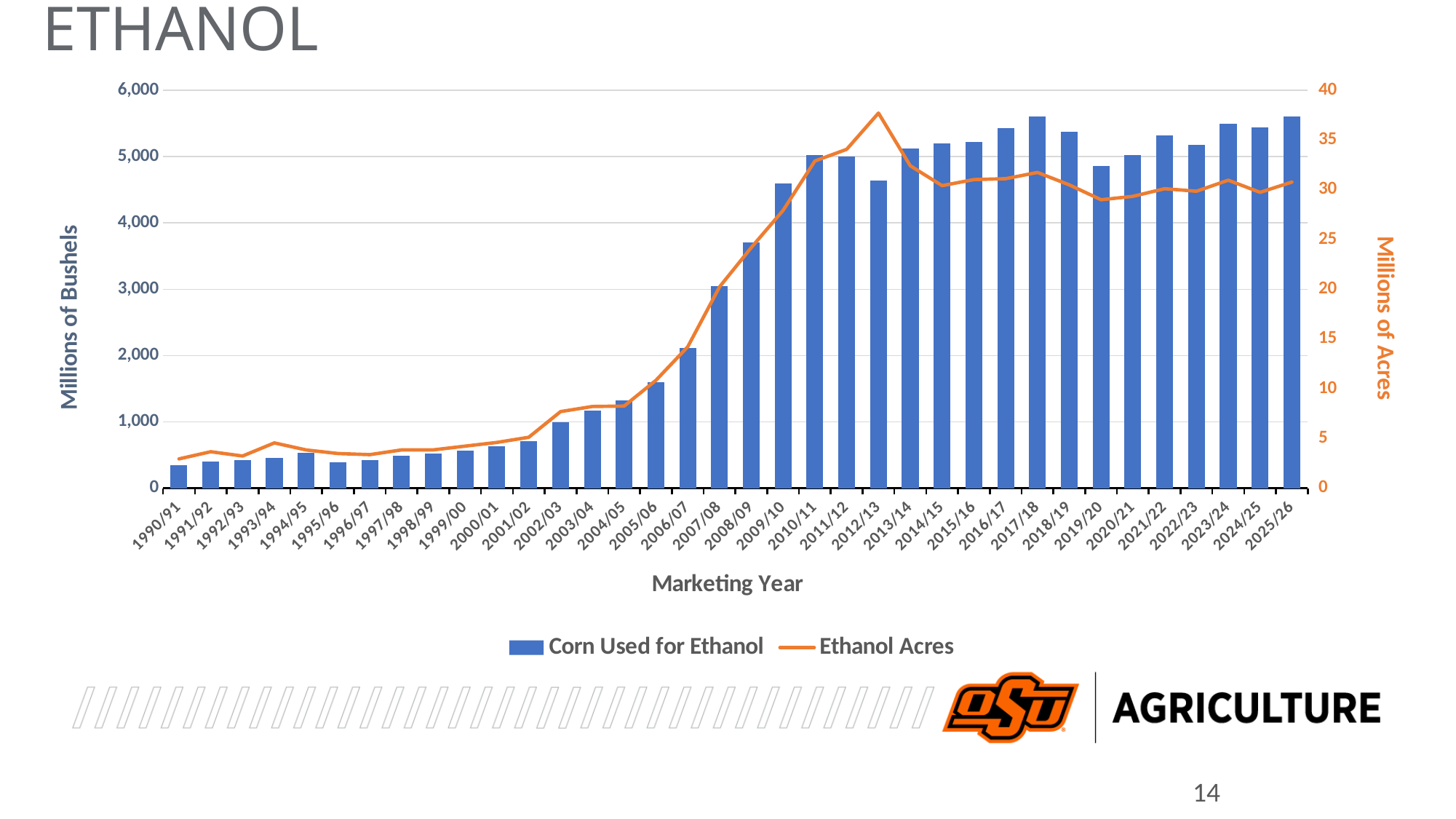
Is the Corn Used for Ethanol value for 2012/13 greater or less than 5,000? less What is the label of the left vertical axis? Millions of Bushels Which marketing year has the highest value for Ethanol Acres? 2012/13 Is the Ethanol Acres value for 2019/20 greater or less than 30? less Is the Ethanol Acres value for 2012/13 greater or less than 35? greater How many marketing years are shown on the x axis? 36 Does Corn Used for Ethanol rise or fall from 1990/91 to 2010/11? rise Which has the larger Corn Used for Ethanol value, 2017/18 or 2019/20? 2017/18 How many series does the legend list? 2 What kind of chart is this? A bar chart with a line series What are the two series named in the legend? Corn Used for Ethanol and Ethanol Acres